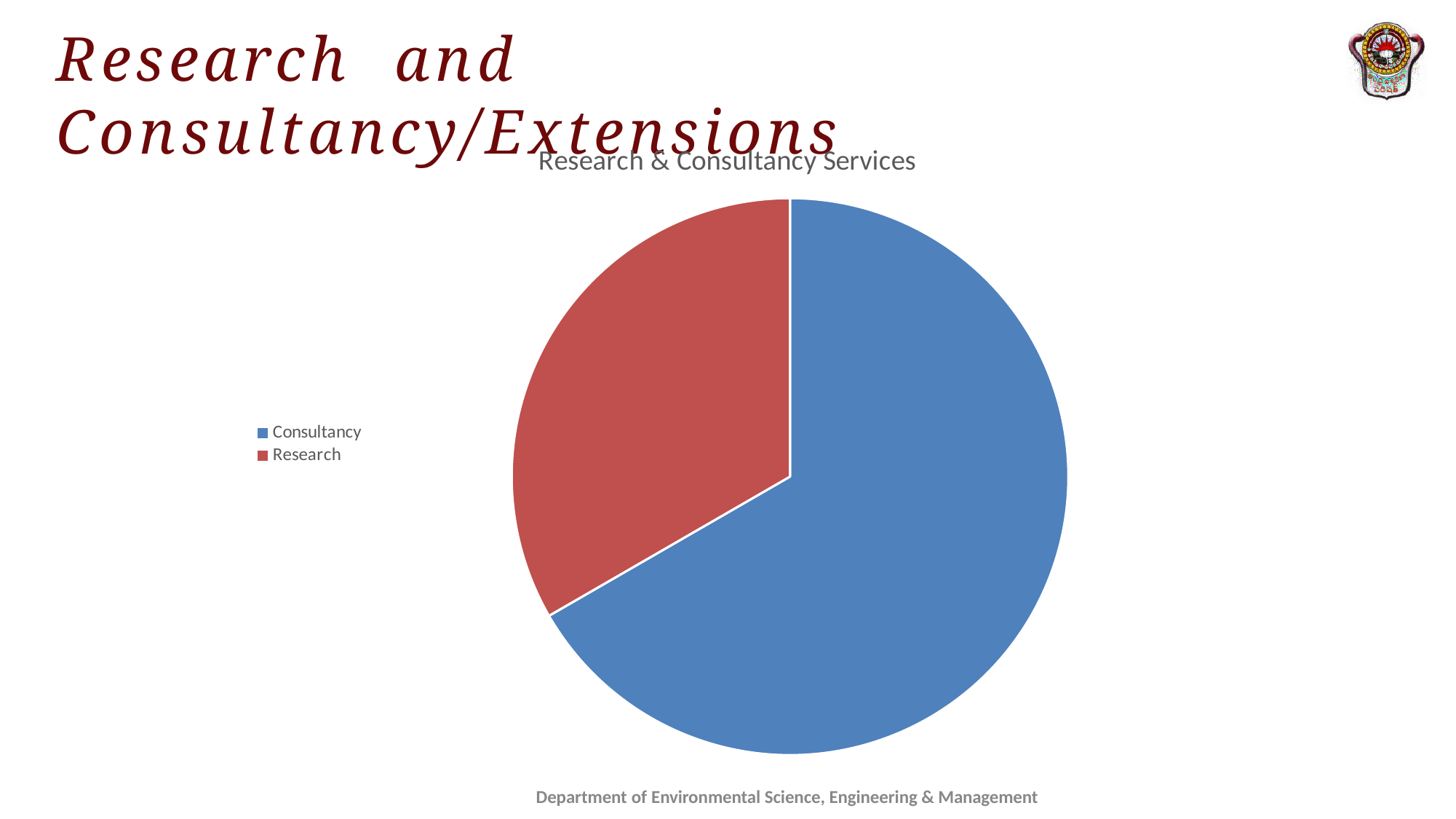
Which category has the smallest slice of the pie? Research Which slice is larger, Consultancy or Research? Consultancy What is the title of the chart? Research & Consultancy Services What kind of chart is shown on the slide? pie chart Is the Research slice greater or less than half of the pie? less How many slices does the pie chart have? 2 What colour is the Consultancy slice? blue Is the Consultancy slice greater or less than half of the pie? greater Which category has the largest slice of the pie? Consultancy How many entries does the legend list? 2